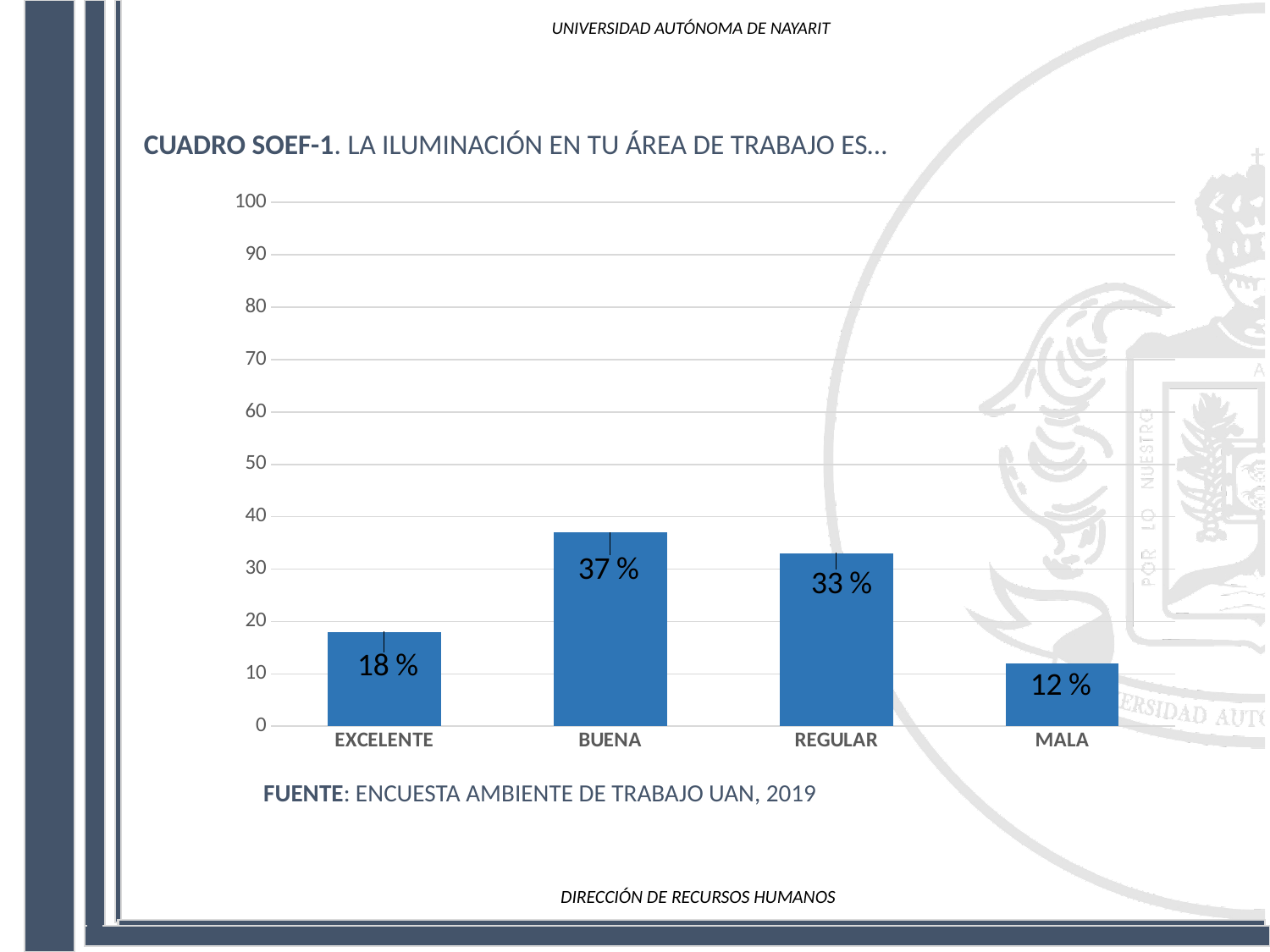
What kind of chart is shown on the slide? bar chart Which category has the lowest value? MALA Which category has the highest value? BUENA What is the value for BUENA? 37 % What is the value for REGULAR? 33 % How many categories are shown on the x axis? 4 Which is larger, the value for EXCELENTE or the value for REGULAR? REGULAR What is the value for MALA? 12 % Is the value for BUENA greater or less than 40? less What is the difference between the values for BUENA and REGULAR? 4 % What is the difference between the values for EXCELENTE and MALA? 6 % What is the value for EXCELENTE? 18 %